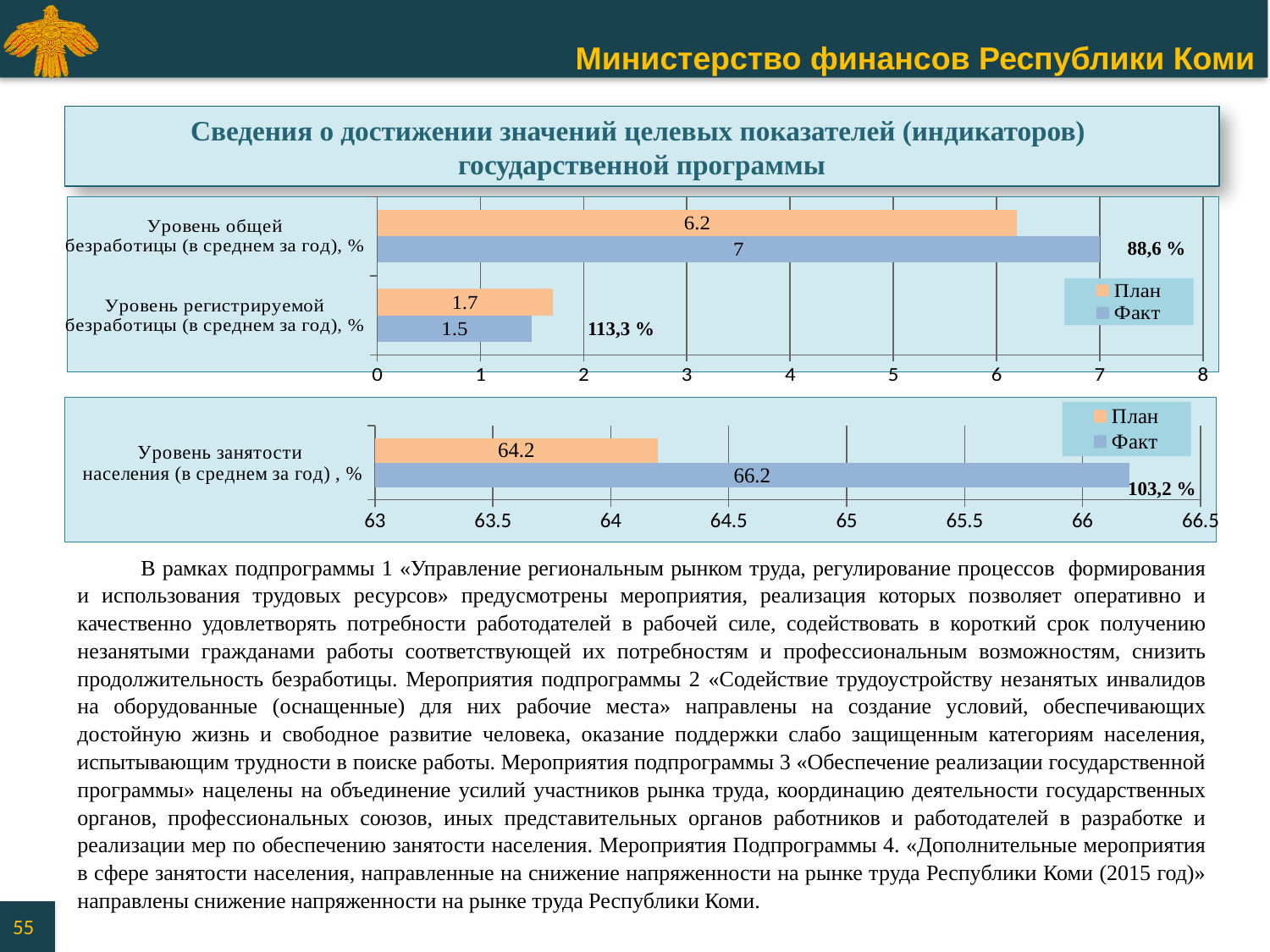
In the top chart, how many series does the legend list? 2 In the bottom chart, what is the difference between the Факт and План values for Уровень занятости населения? 2 In the top chart, what is the Факт value for Уровень общей безработицы (в среднем за год), %? 7 In the bottom chart, which colour represents the Факт series? Blue In the bottom chart, what is the План value for Уровень занятости населения (в среднем за год), %? 64.2 In the bottom chart, what is the Факт value for Уровень занятости населения (в среднем за год), %? 66.2 What kind of chart is the top chart? Bar chart In the top chart, what is the difference between the Факт and План values for Уровень общей безработицы? 0.8 In the top chart, which is larger for Уровень регистрируемой безработицы: План or Факт? План In the top chart, what is the План value for Уровень общей безработицы (в среднем за год), %? 6.2 In the top chart, what is the Факт value for Уровень регистрируемой безработицы (в среднем за год), %? 1.5 In the top chart, how many categories are shown? 2